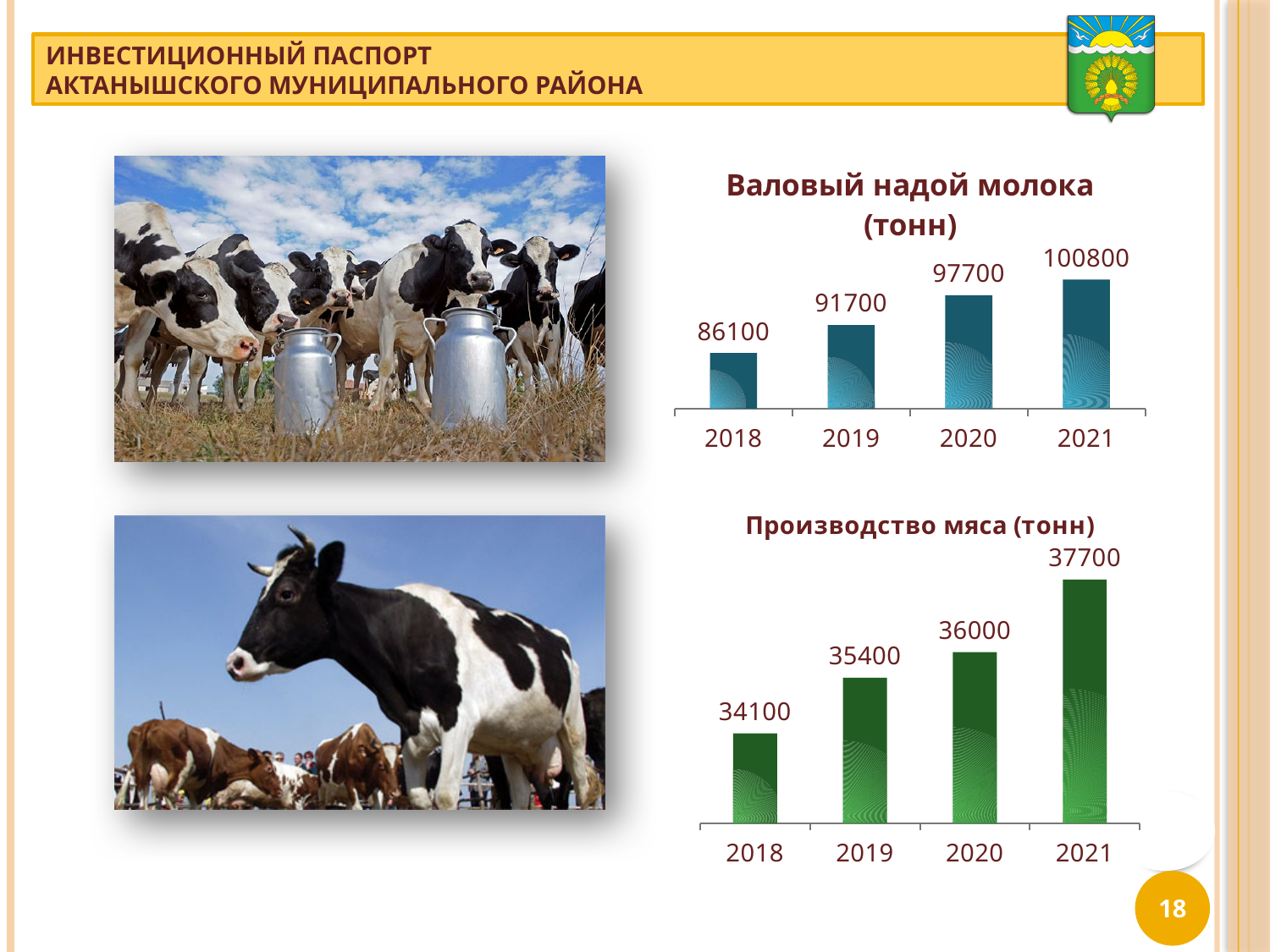
In the 'Валовый надой молока (тонн)' chart, what is the difference between the 2021 and 2018 values? 14700 What type of chart is the 'Производство мяса (тонн)' chart? bar chart In the 'Производство мяса (тонн)' chart, which is larger, the value for 2019 or the value for 2020? 2020 In the 'Производство мяса (тонн)' chart, which year has the highest value? 2021 In the 'Валовый надой молока (тонн)' chart, which year has the lowest value? 2018 In the 'Валовый надой молока (тонн)' chart, do the values rise or fall from 2018 to 2021? rise In the 'Производство мяса (тонн)' chart, what is the difference between the 2021 and 2020 values? 1700 In the 'Валовый надой молока (тонн)' chart, which year has the highest value? 2021 In the 'Производство мяса (тонн)' chart, what is the value for 2018? 34100 In the 'Валовый надой молока (тонн)' chart, how many years are shown? 4 In the 'Валовый надой молока (тонн)' chart, what is the value for 2019? 91700 In the 'Производство мяса (тонн)' chart, what is the value for 2020? 36000